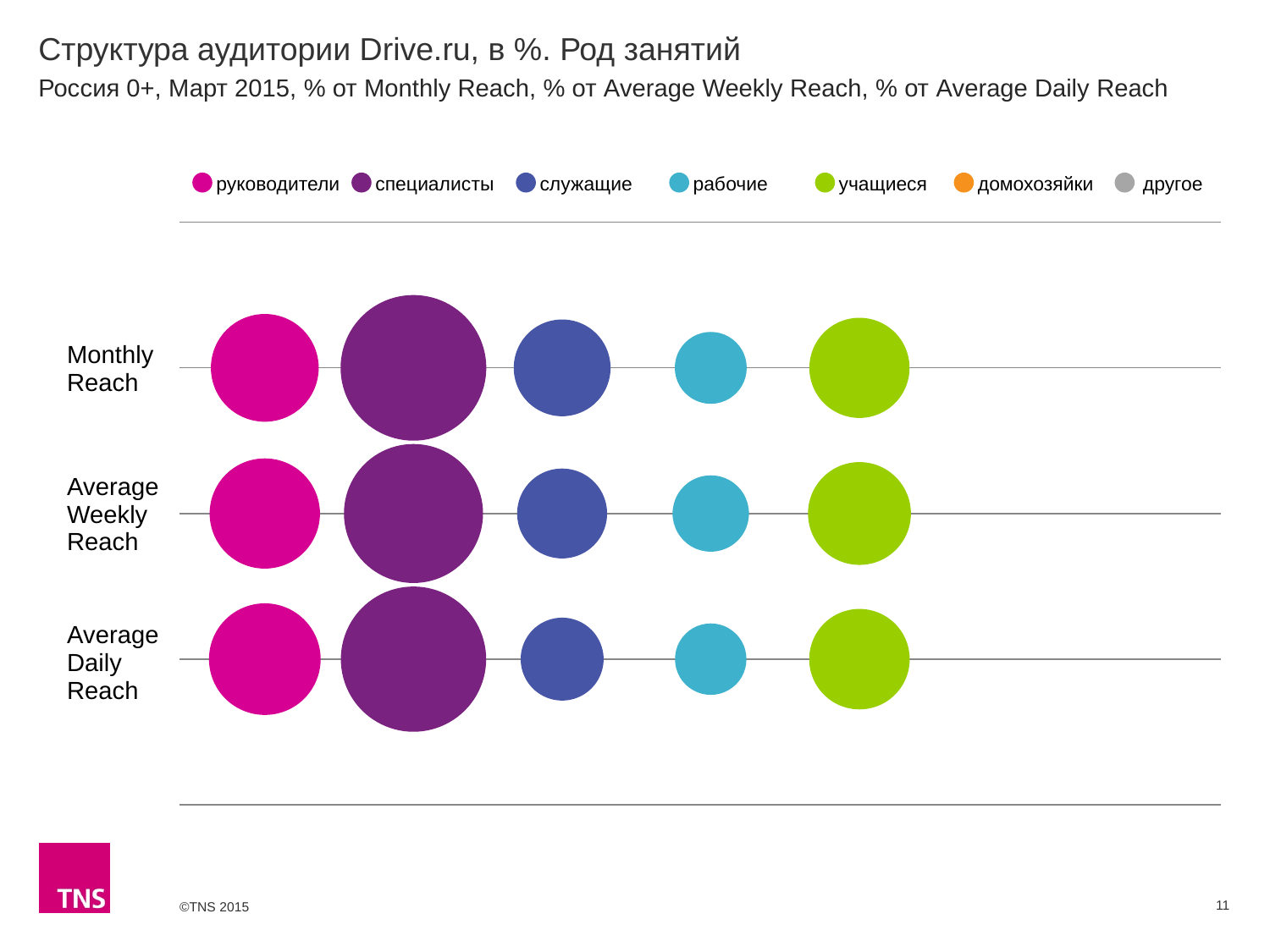
In the Average Daily Reach row, which bubble is larger: руководители or служащие? руководители How many reach categories (rows) are plotted on the chart? 3 What is the title of the chart on the slide? Структура аудитории Drive.ru, в %. Род занятий What kind of chart is shown on the slide? bubble chart Which occupation group has the largest bubble in the Monthly Reach row? специалисты In the Monthly Reach row, which bubble is larger: учащиеся or рабочие? учащиеся Which occupation group has the largest bubble in the Average Daily Reach row? специалисты How many series does the legend list? 7 Among the visible bubbles in the Monthly Reach row, which occupation group has the smallest? рабочие Which two legend entries have no visible bubble plotted in any row? домохозяйки and другое In the Average Weekly Reach row, which bubble is larger: специалисты or рабочие? специалисты